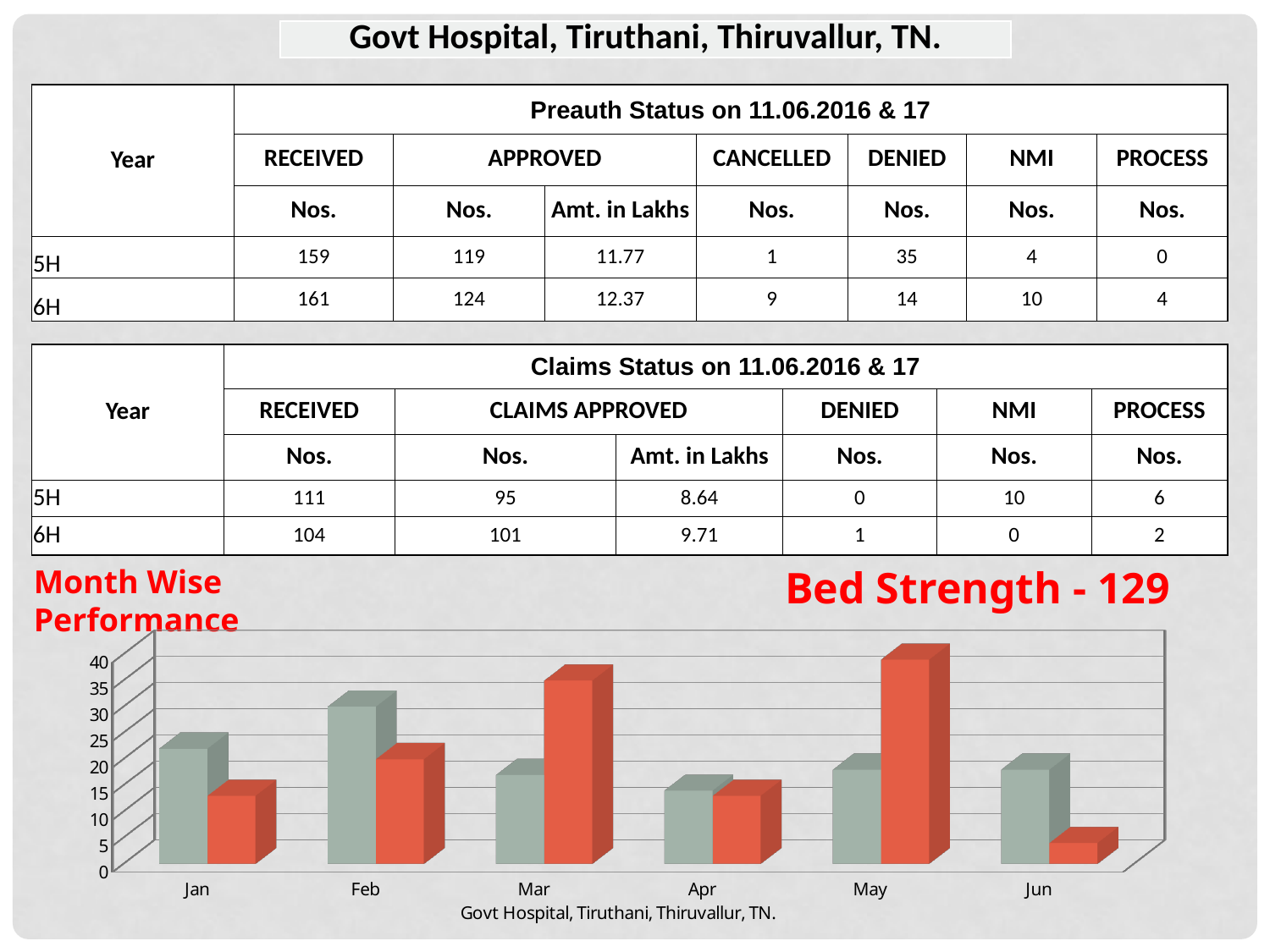
In the Month Wise Performance chart, is the orange bar for Jun greater or less than 10? less In the Month Wise Performance chart, is the grey bar for Feb greater or less than 25? greater What text appears below the x axis of the Month Wise Performance chart? Govt Hospital, Tiruthani, Thiruvallur, TN. In the Month Wise Performance chart, which month has the shortest orange bar? Jun In the Month Wise Performance chart, which month has the tallest grey bar? Feb What kind of chart is shown under 'Month Wise Performance'? bar chart In the Month Wise Performance chart, which month has the tallest orange bar? May In the Month Wise Performance chart, is the orange bar for May greater or less than 35? greater In the Month Wise Performance chart, for Feb, which bar is taller, the grey one or the orange one? the grey one In the Month Wise Performance chart, for Mar, which bar is taller, the grey one or the orange one? the orange one How many months are shown on the x axis of the Month Wise Performance chart? 6 In the Month Wise Performance chart, which month has the shortest grey bar? Apr